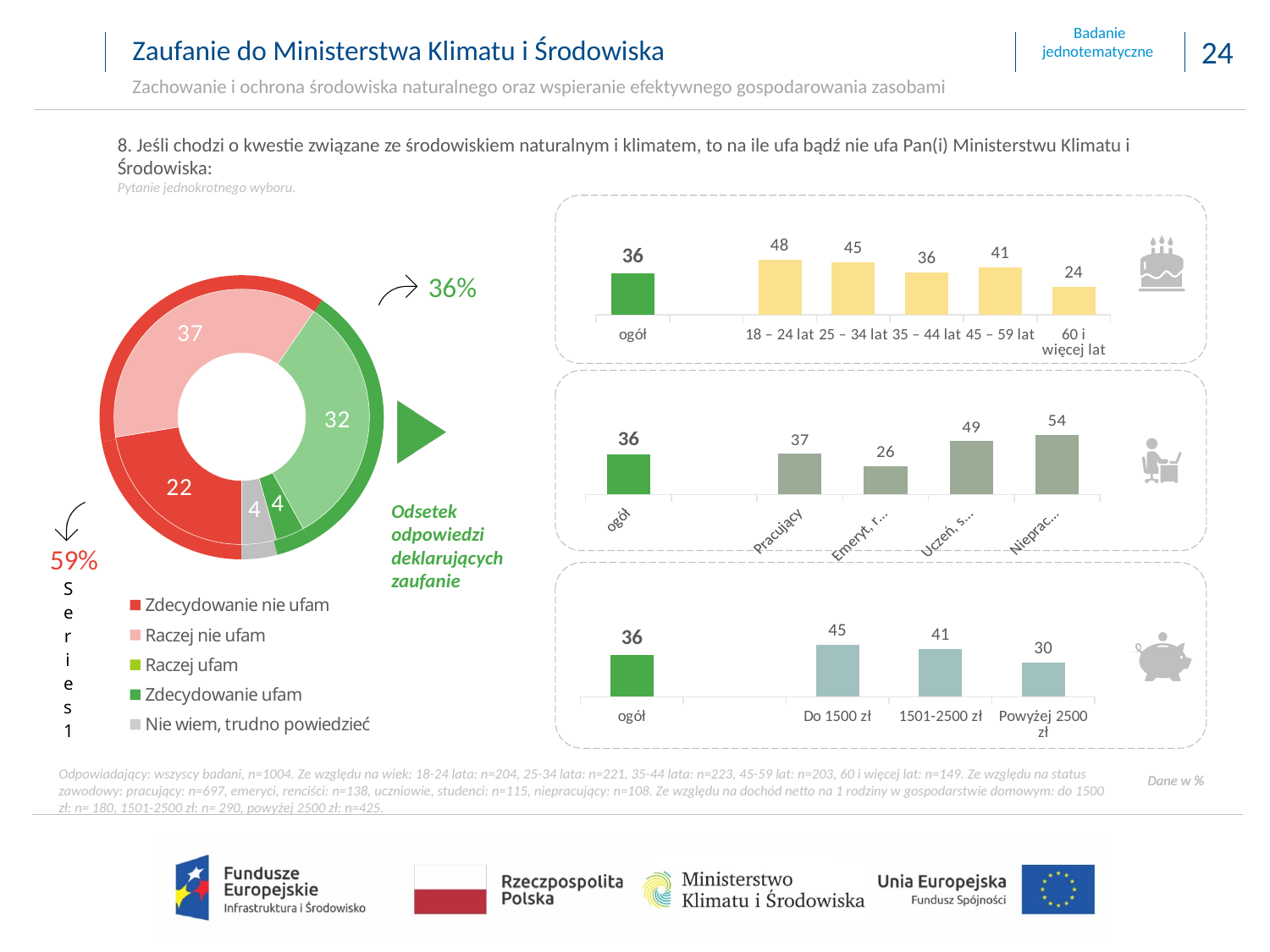
What kind of chart is the chart on the left of the slide? donut (pie) chart In the income bar chart (bottom right), do the values rise or fall from Do 1500 zł to Powyżej 2500 zł? fall In the occupational-status bar chart (middle right), what is the highest value shown? 54 In the age-group bar chart (top right), which is larger: the value for 25 – 34 lat or 45 – 59 lat? 25 – 34 lat In the age-group bar chart (top right), what is the difference between the values for 18 – 24 lat and 60 i więcej lat? 24 How many entries does the legend of the donut chart on the left list? 5 In the age-group bar chart (top right), which age group has the lowest value? 60 i więcej lat In the income bar chart (bottom right), what is the difference between the values for Do 1500 zł and Powyżej 2500 zł? 15 In the occupational-status bar chart (middle right), what is the value for Pracujący? 37 In the donut chart on the left, what is the value for Raczej nie ufam? 37 In the age-group bar chart (top right), what is the value for 18 – 24 lat? 48 In the income bar chart (bottom right), what is the value for Do 1500 zł? 45